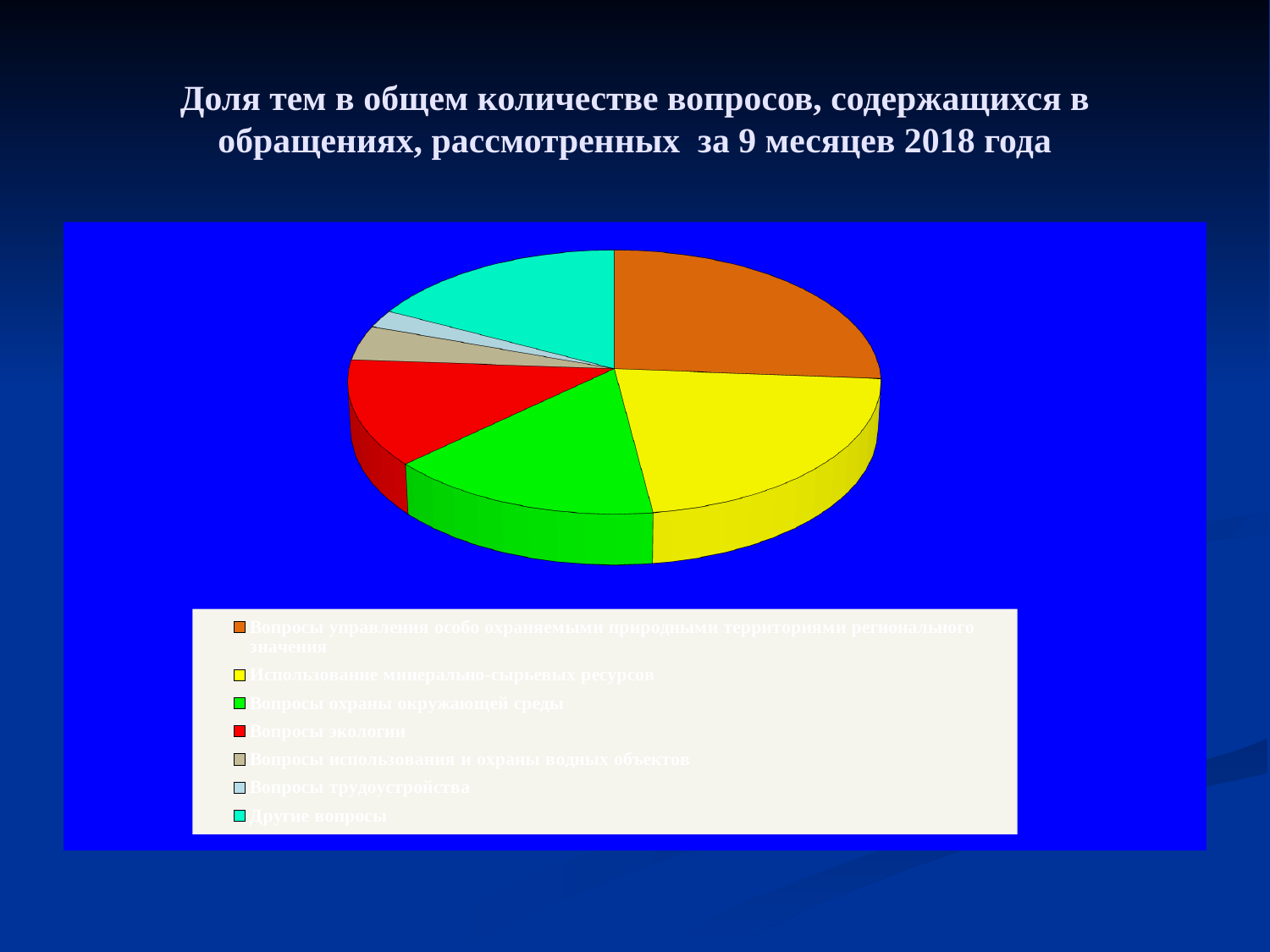
How many categories (slices) does the pie chart's legend list? 7 Which slice is larger: Вопросы управления особо охраняемыми природными территориями регионального значения or Вопросы экологии? Вопросы управления особо охраняемыми природными территориями регионального значения Which category has the smallest slice of the pie? Вопросы трудоустройства What colour represents Вопросы экологии in the pie chart? Red What kind of chart is shown on the slide? Pie chart Which slice is larger: Вопросы охраны окружающей среды or Вопросы экологии? Вопросы охраны окружающей среды Which slice is larger: Использование минерально-сырьевых ресурсов or Вопросы трудоустройства? Использование минерально-сырьевых ресурсов What is the title of the slide containing the pie chart? Доля тем в общем количестве вопросов, содержащихся в обращениях, рассмотренных за 9 месяцев 2018 года